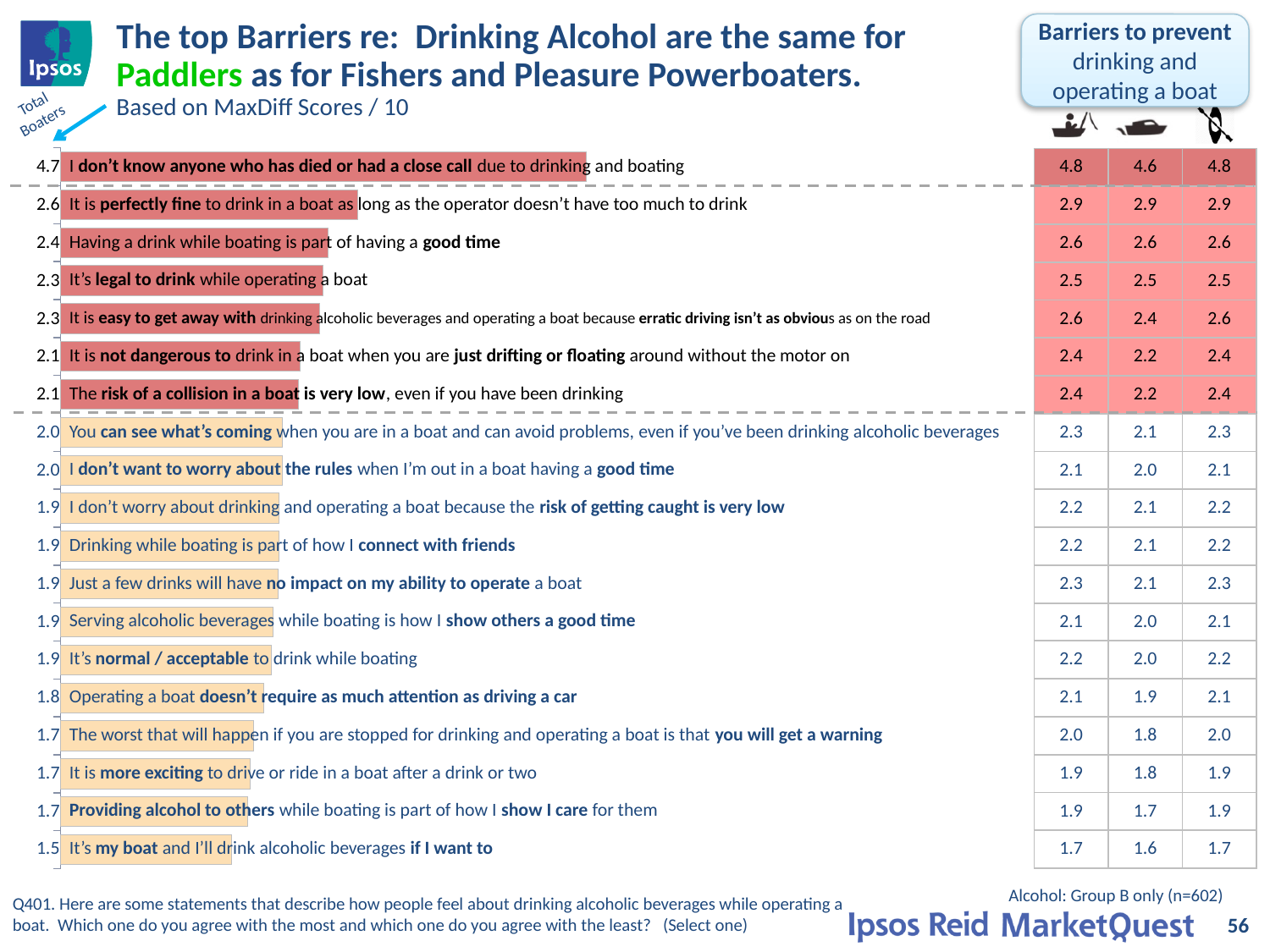
How many bars in the chart are shaded red/pink rather than orange? 7 Which statement has the highest Total Boaters score in the bar chart? I don't know anyone who has died or had a close call due to drinking and boating How many statements (bars) are shown in the bar chart? 19 What is the Total Boaters score for "Operating a boat doesn't require as much attention as driving a car"? 1.8 Which statement has the lowest Total Boaters score in the bar chart? It's my boat and I'll drink alcoholic beverages if I want to Do the Total Boaters scores increase or decrease going from the top bar to the bottom bar? Decrease What is the difference between the Total Boaters scores for "I don't know anyone who has died or had a close call" and "It is perfectly fine to drink in a boat as long as the operator doesn't have too much to drink"? 2.1 What is the Total Boaters MaxDiff score for the statement "I don't know anyone who has died or had a close call due to drinking and boating"? 4.7 What is the Total Boaters score for "It's legal to drink while operating a boat"? 2.3 Which has a higher Total Boaters score: "It is perfectly fine to drink in a boat as long as the operator doesn't have too much to drink" or "Having a drink while boating is part of having a good time"? It is perfectly fine to drink in a boat as long as the operator doesn't have too much to drink What kind of chart is used to show the Total Boaters scores? Bar chart What is the difference between the Total Boaters scores for "Having a drink while boating is part of having a good time" and "It's my boat and I'll drink alcoholic beverages if I want to"? 0.9